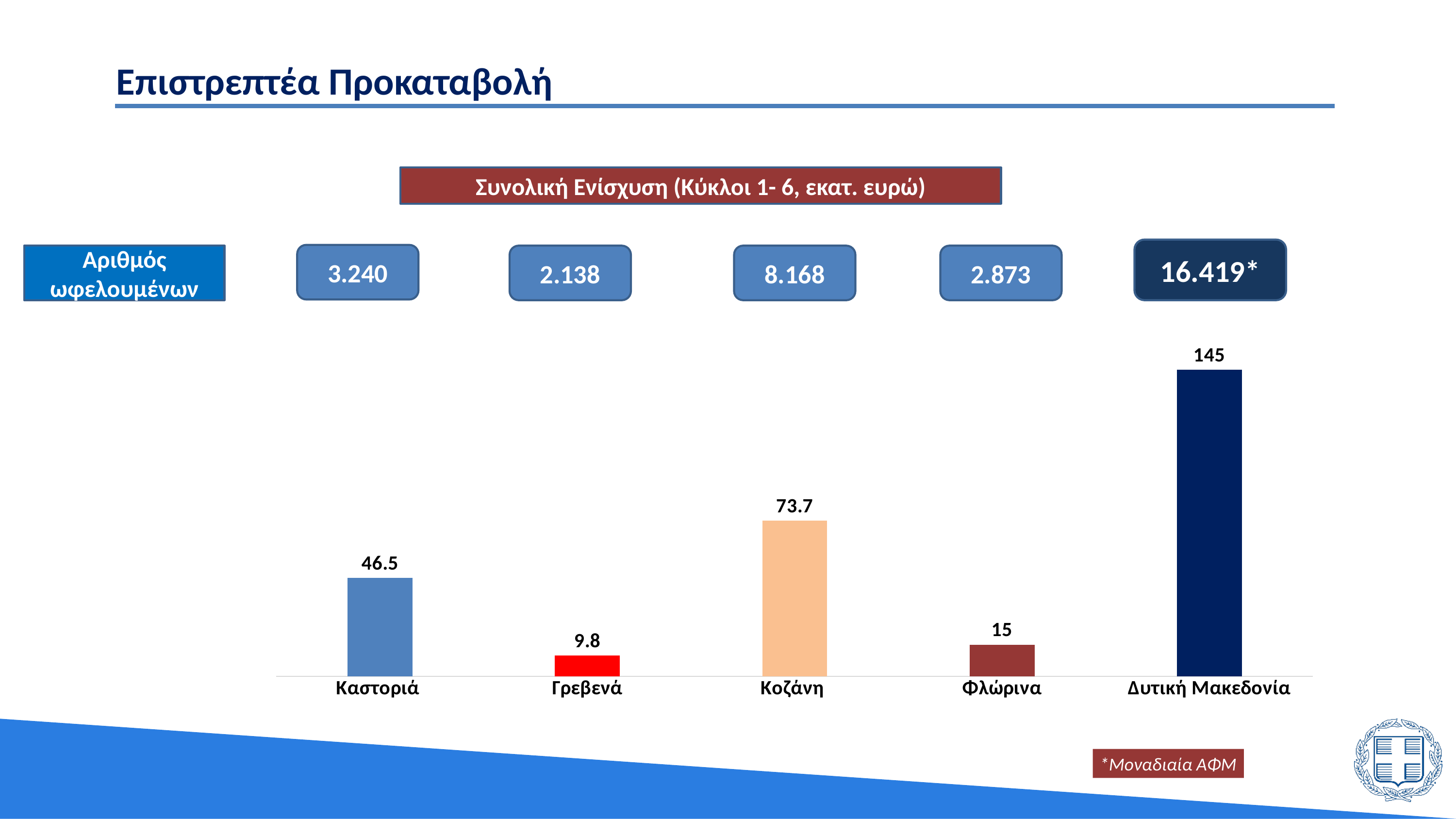
What is the difference between the values for Κοζάνη and Καστοριά? 27.2 What is the value for Γρεβενά? 9.8 Which category has the lowest value? Γρεβενά What colour is the bar for Γρεβενά? Red What is the value for Κοζάνη? 73.7 What is the value for Φλώρινα? 15 What is the value for Καστοριά? 46.5 What is the title shown above the chart? Συνολική Ενίσχυση (Κύκλοι 1- 6, εκατ. ευρώ) How many categories are shown on the x axis? 5 What kind of chart is shown on the slide? Bar chart Which category has the highest value? Δυτική Μακεδονία Which is larger, the value for Φλώρινα or the value for Γρεβενά? Φλώρινα